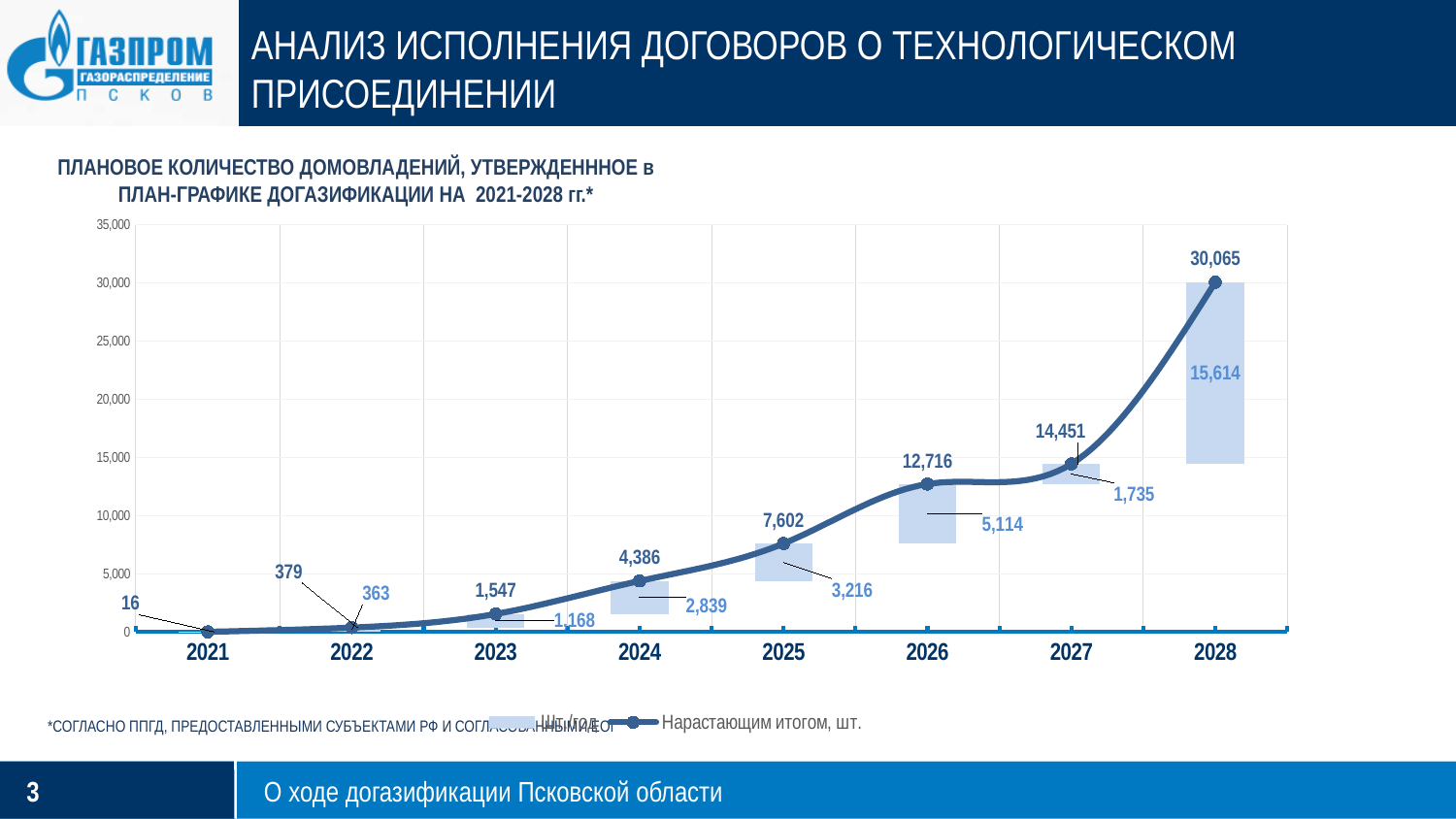
What is the cumulative value (Нарастающим итогом) for 2025? 7,602 What is the cumulative value (Нарастающим итогом) for 2028? 30,065 Which is larger, the annual value for 2025 or the annual value for 2027? 2025 What is the annual value (Шт./год bar) for 2026? 5,114 Is the cumulative value for 2026 greater or less than 10,000? greater How many years are shown on the x axis? 8 How many series does the legend list? 2 Which year has the lowest cumulative value (Нарастающим итогом)? 2021 Which year has the highest annual value (Шт./год bar)? 2028 What is the annual value (Шт./год bar) for 2023? 1,168 Does the cumulative line rise or fall from 2021 to 2028? rise What is the difference between the cumulative values for 2028 and 2027? 15,614